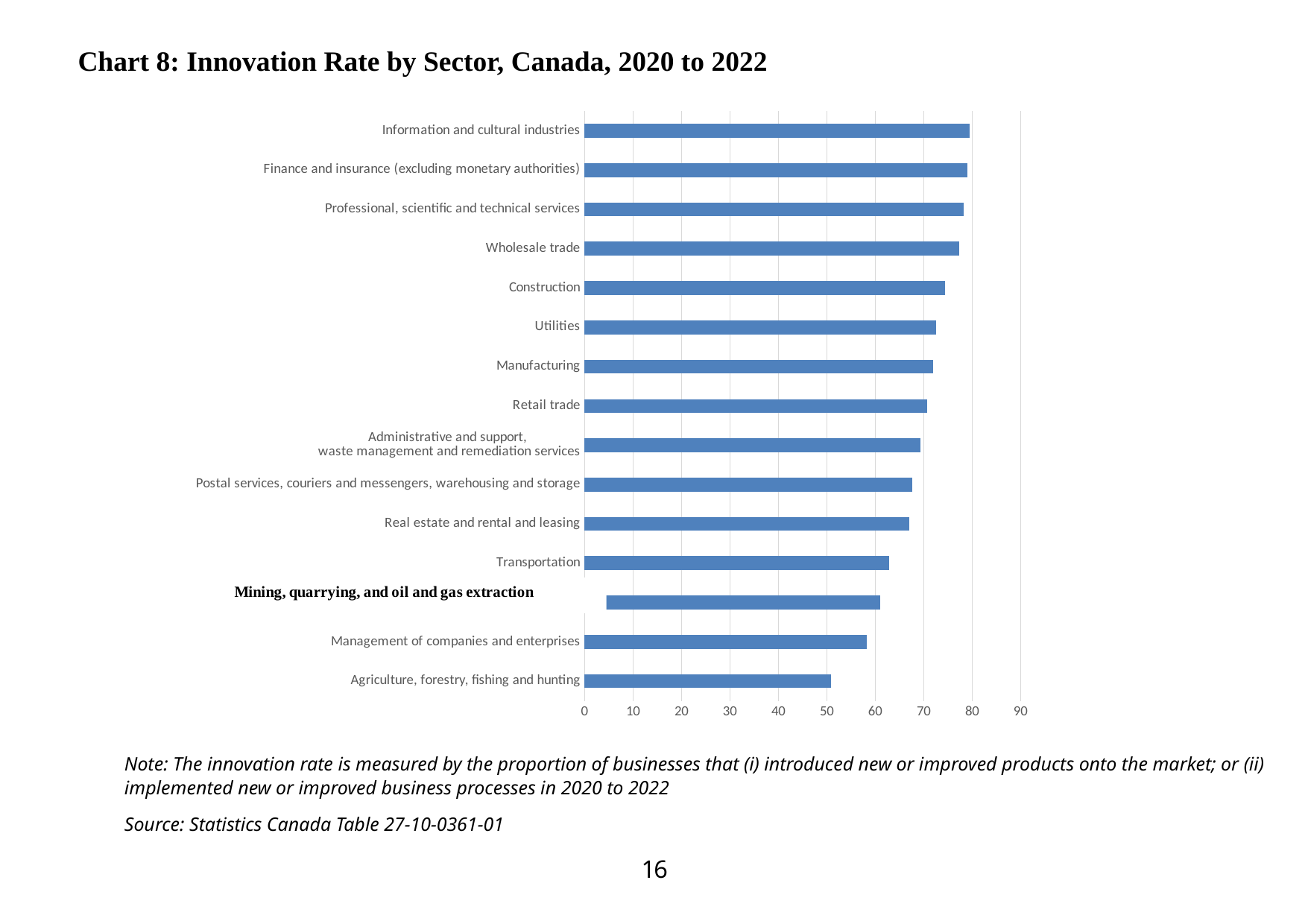
Are the bars arranged in increasing or decreasing order of value from top to bottom? decreasing What is the title of the chart? Chart 8: Innovation Rate by Sector, Canada, 2020 to 2022 Which sector has the lowest innovation rate? Agriculture, forestry, fishing and hunting Is the value for Construction greater or less than 70? greater How many sectors are plotted in the chart? 15 Is the value for Real estate and rental and leasing greater or less than 70? less Is the value for Wholesale trade greater or less than 70? greater Which has a higher innovation rate, Construction or Transportation? Construction What kind of chart is shown on the slide? bar chart Which has a higher innovation rate, Manufacturing or Management of companies and enterprises? Manufacturing